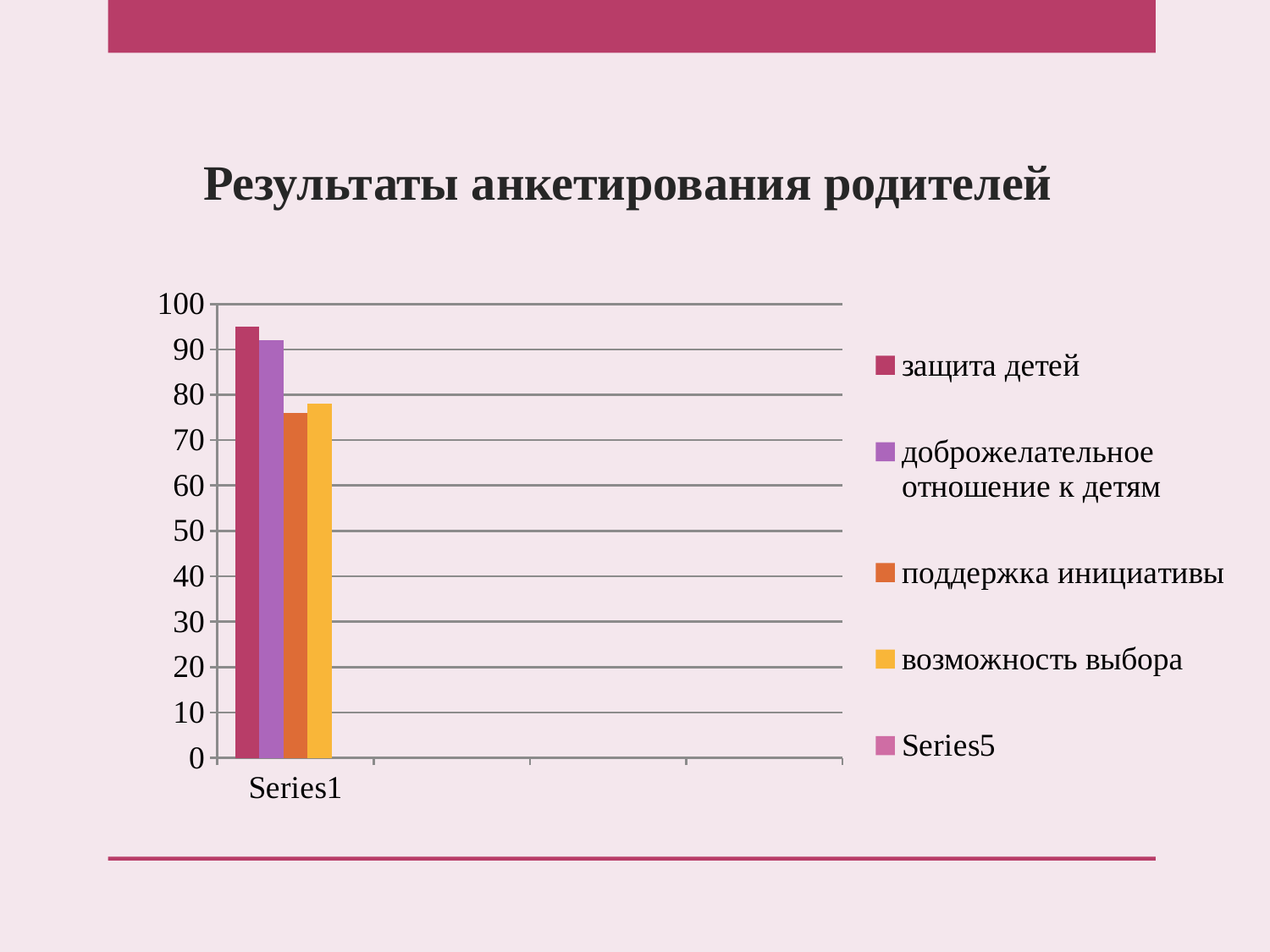
How many series does the legend list? 5 How many categories are shown on the x axis? 1 What is the label of the single category on the x axis? Series1 Is the value for защита детей greater or less than 90? greater What kind of chart is shown on the slide? bar chart Which series has the tallest bar? защита детей What is the title of the slide above the chart? Результаты анкетирования родителей Is the value for поддержка инициативы greater or less than 80? less Is the value for поддержка инициативы greater or less than 70? greater Which is larger, the value for доброжелательное отношение к детям or the value for возможность выбора? доброжелательное отношение к детям Which is larger, the value for защита детей or the value for поддержка инициативы? защита детей